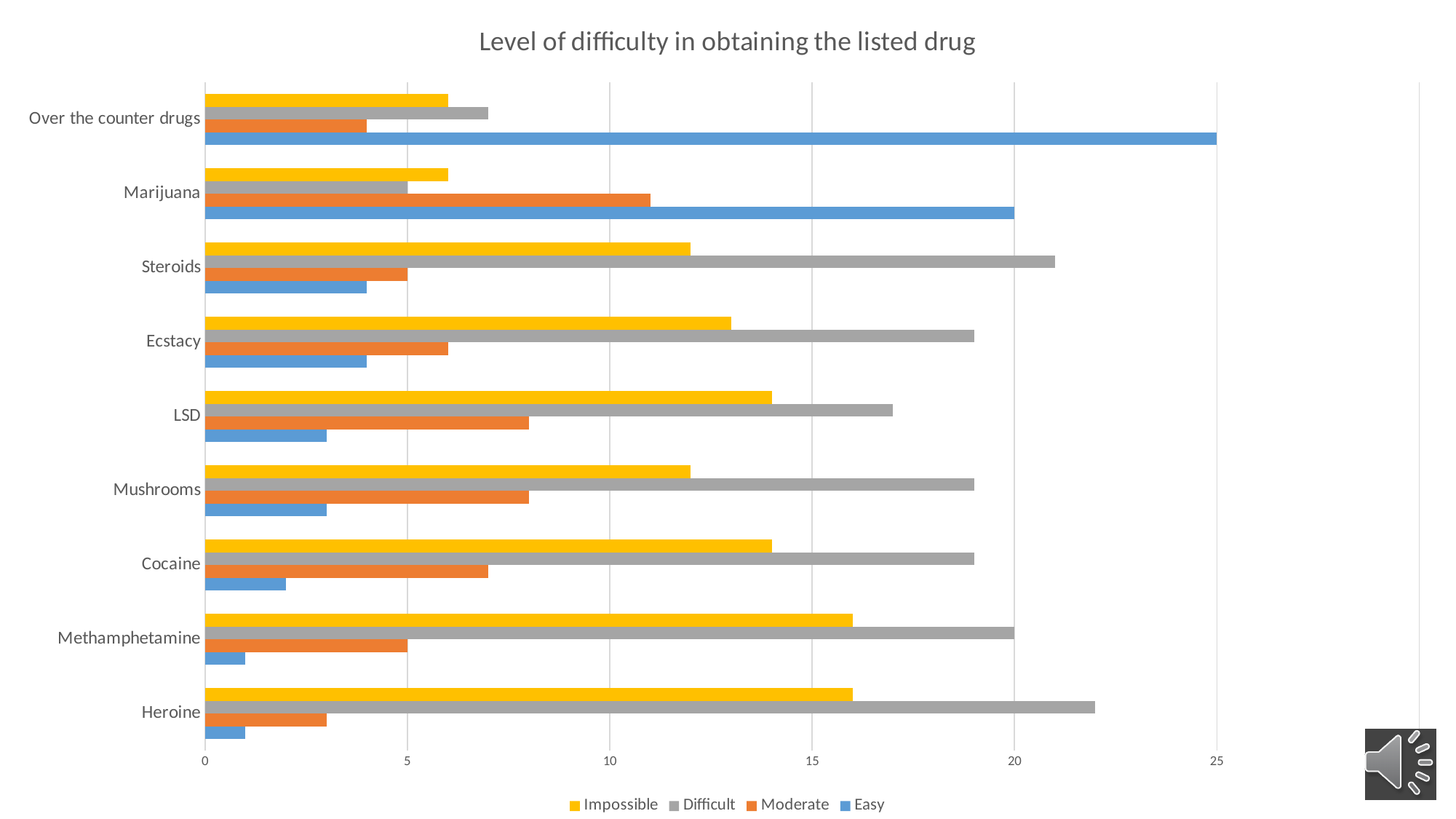
Is the Easy value for Cocaine greater or less than 5? less What is the Difficult value for Methamphetamine? 20 Which drug has the highest Easy value? Over the counter drugs What is the Easy value for Marijuana? 20 How many drug categories are listed on the chart? 9 For Heroine, which is larger: the Difficult value or the Easy value? Difficult How many series does the legend list? 4 Which drug has the highest Moderate value? Marijuana What type of chart is shown on the slide? bar chart What is the title of the chart? Level of difficulty in obtaining the listed drug Is the Difficult value for Heroine greater or less than 20? greater What is the Easy value for Over the counter drugs? 25